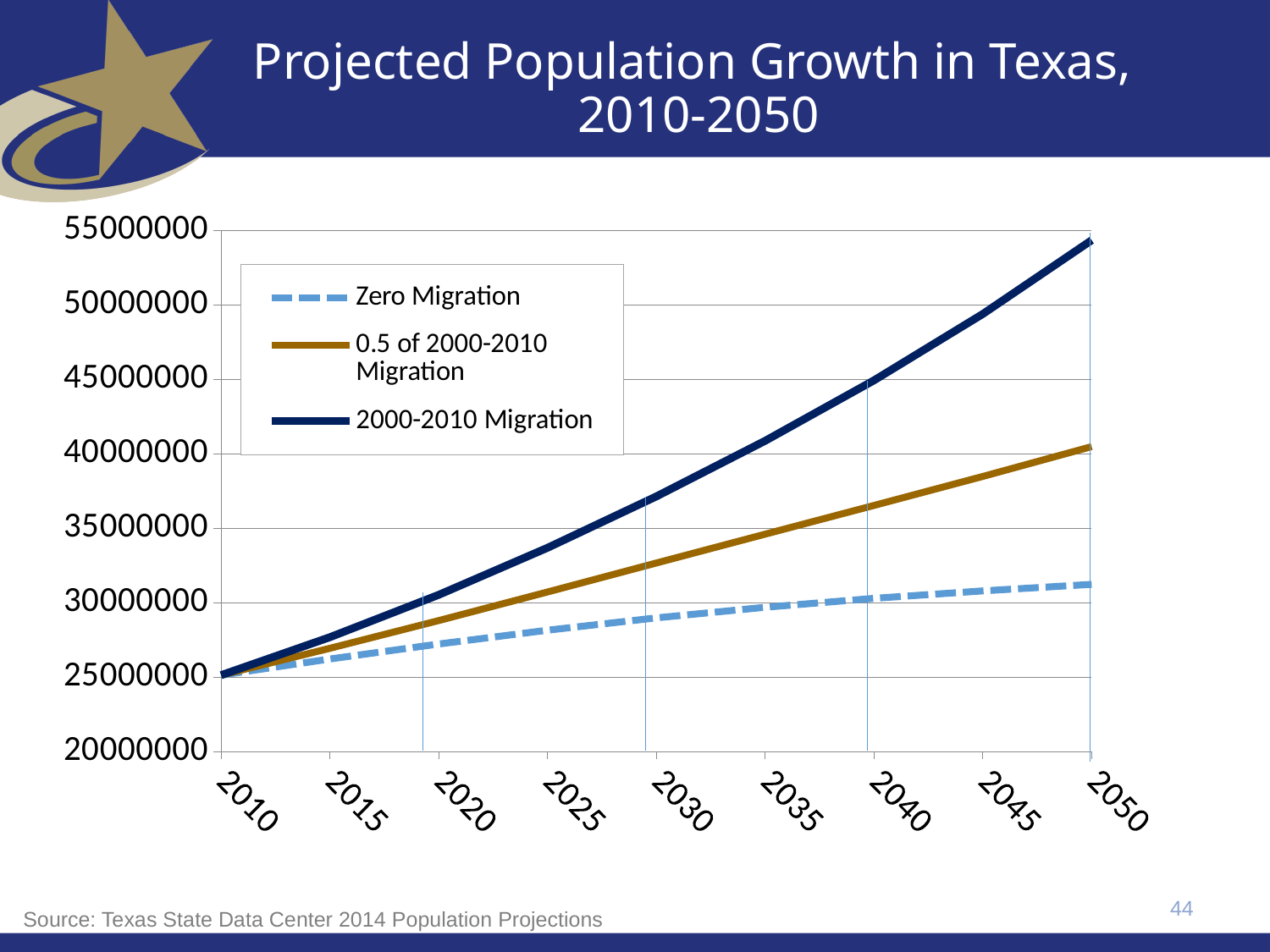
Do the values for 2000-2010 Migration rise or fall from 2010 to 2050? rise What kind of chart is shown on the slide? line chart Which series has the lowest value in 2050? Zero Migration In 2040, which is larger: the value for 0.5 of 2000-2010 Migration or the value for Zero Migration? 0.5 of 2000-2010 Migration Is the value for Zero Migration in 2050 greater or less than 35000000? less Which series has the highest value in 2050? 2000-2010 Migration Is the value for 2000-2010 Migration in 2040 greater or less than 40000000? greater How many series does the legend list? 3 Which series is drawn with a dashed line? Zero Migration Is the value for 2000-2010 Migration in 2050 greater or less than 50000000? greater How many year labels are shown along the x axis? 9